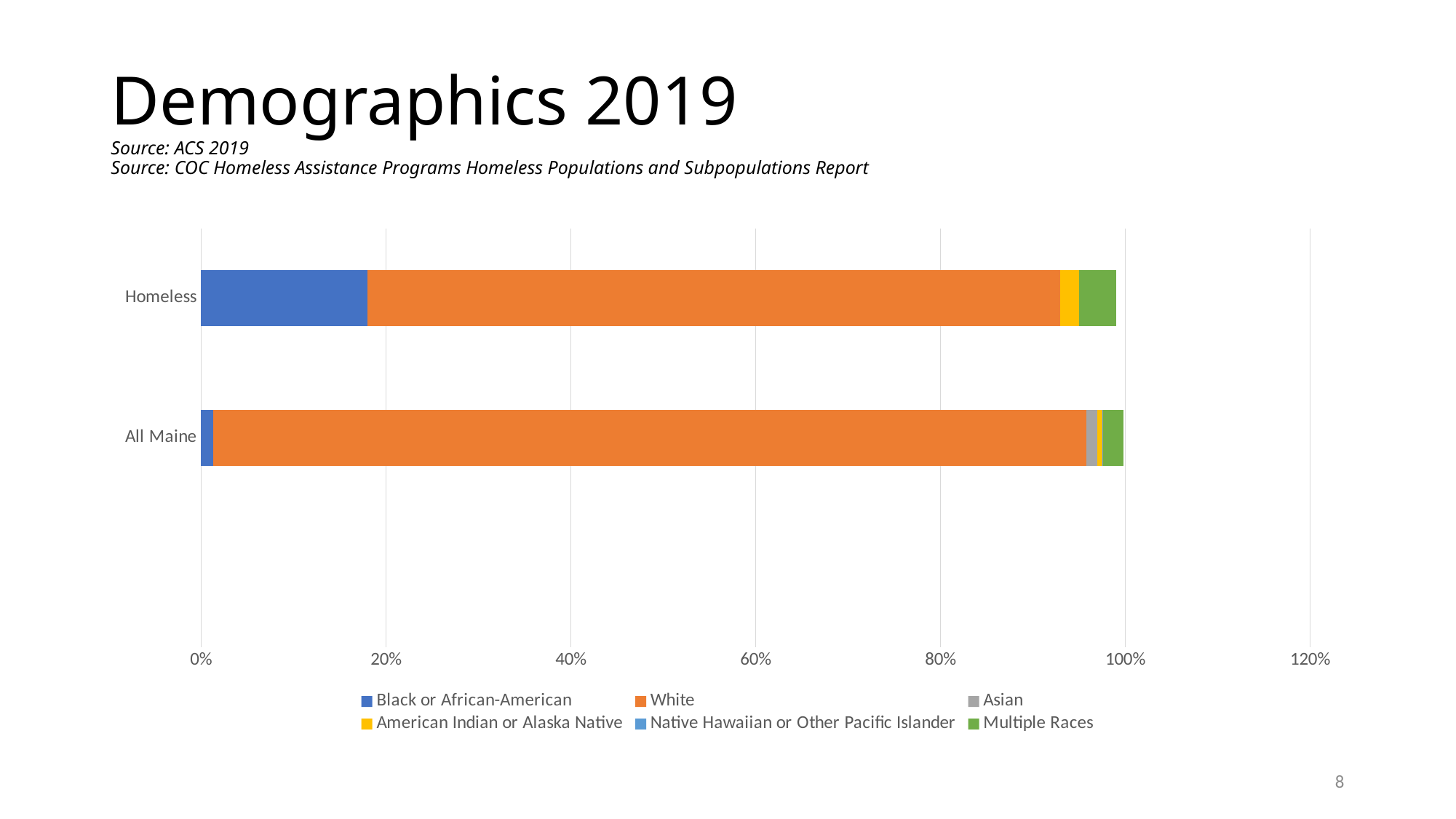
What is the title of the slide containing the chart? Demographics 2019 How many categories are plotted on the chart? 2 Is the White value for All Maine greater or less than 80%? greater Which category has the larger Black or African-American share, Homeless or All Maine? Homeless What colour represents the White series in the chart? orange Which series makes up the largest part of the Homeless bar? White What kind of chart is shown on the slide? stacked bar chart Which category has the larger White share, Homeless or All Maine? All Maine Is the Black or African-American value for All Maine greater or less than 20%? less How many series does the legend list? 6 Is the White value for Homeless greater or less than 60%? greater